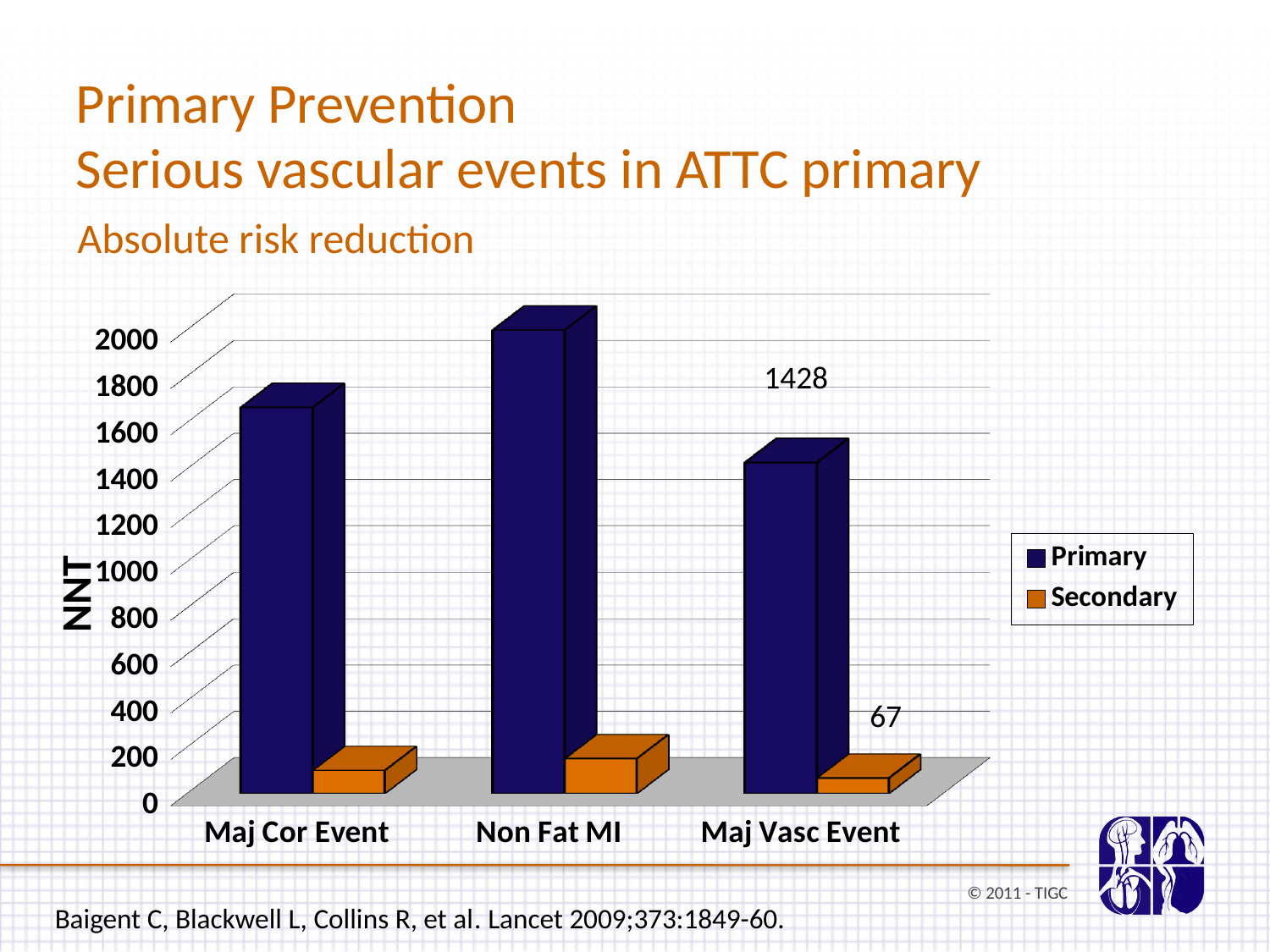
What is the label on the vertical axis of the chart? NNT Is the Secondary NNT value for Non Fat MI greater or less than 400? less What is the NNT value for the Secondary series for Maj Vasc Event? 67 How many series does the legend list? 2 Is the Primary NNT value for Non Fat MI greater or less than 1800? greater Which category has the highest Primary NNT value? Non Fat MI Which category has the lowest Primary NNT value? Maj Vasc Event For Maj Vasc Event, which series has the larger NNT value, Primary or Secondary? Primary What is the difference between the Primary and Secondary NNT values for Maj Vasc Event? 1361 What kind of chart is shown on the slide? Bar chart How many categories are shown on the x axis of the chart? 3 What is the NNT value for the Primary series for Maj Vasc Event? 1428